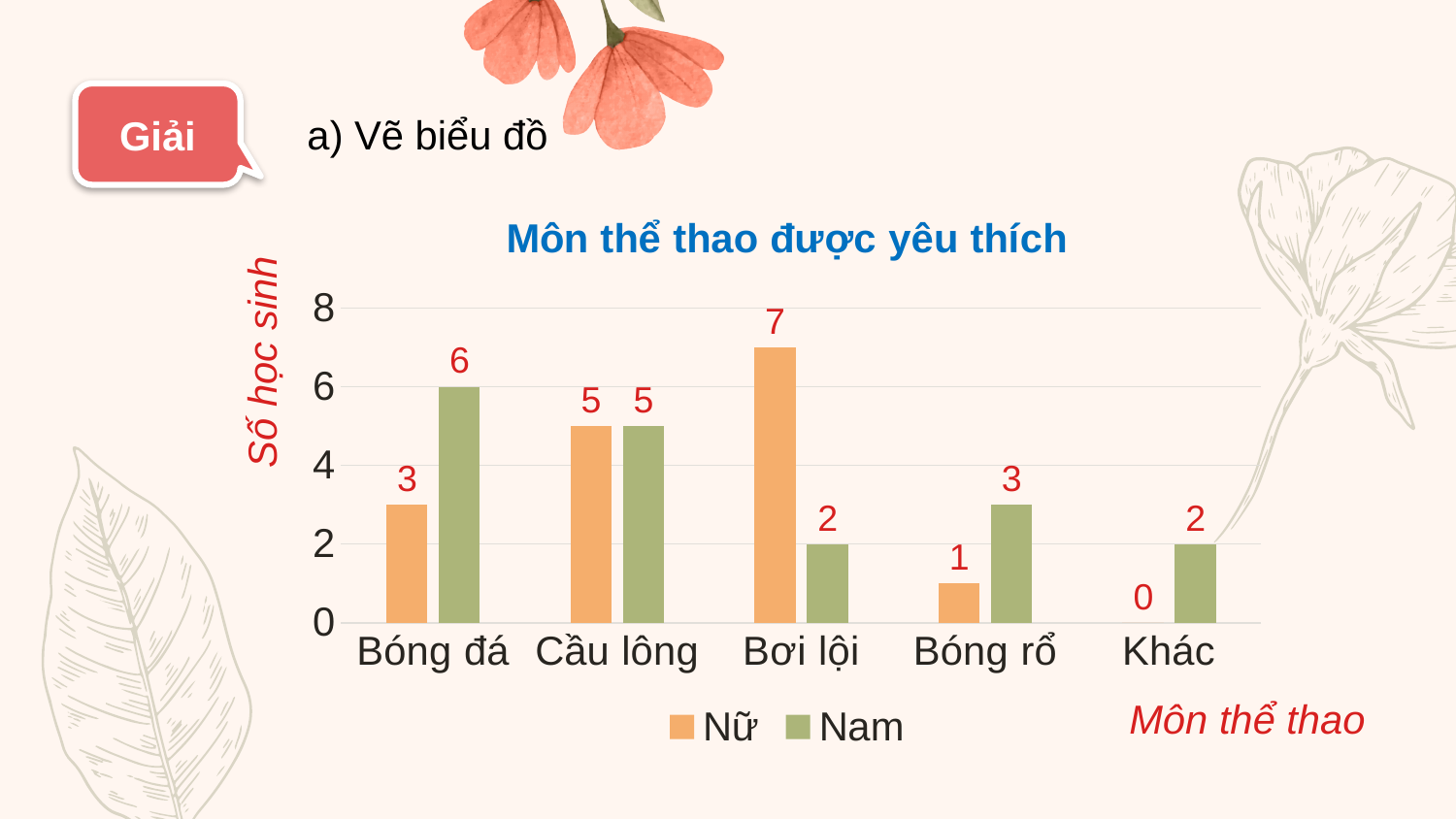
What is the difference between the Nam and Nữ values for Bóng đá? 3 Which is larger for Bóng rổ, the Nữ value or the Nam value? Nam What is the label of the vertical axis? Số học sinh What is the value for Nam in the Bơi lội category? 2 What kind of chart is shown on the slide? bar chart How many categories are shown on the x axis? 5 What is the value for Nữ in the Khác category? 0 What is the title of the chart? Môn thể thao được yêu thích Which category has the lowest value for Nam? Bơi lội and Khác (both 2) What is the value for Nữ in the Bóng đá category? 3 Which category has the highest value for Nữ? Bơi lội How many series does the legend list? 2